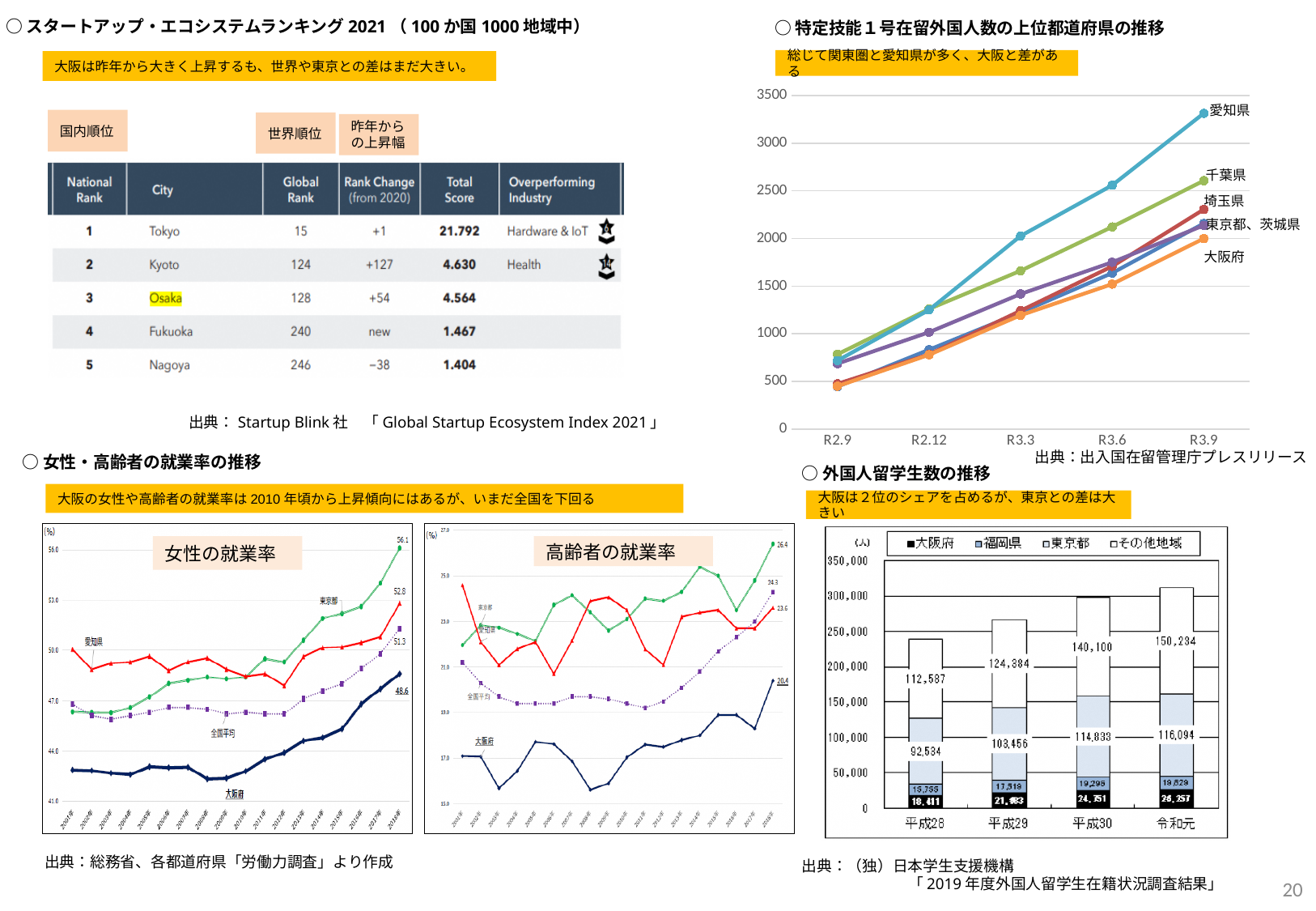
In the 女性の就業率 chart, what is the final labelled value for 愛知県? 52.8 In the bottom-right chart 外国人留学生数の推移, how many series does the legend list? 4 In the top-right chart 特定技能１号在留外国人数の上位都道府県の推移, what kind of chart is it? line chart In the 高齢者の就業率 chart, what is the final labelled value for 大阪府? 20.4 In the top-right chart 特定技能１号在留外国人数の上位都道府県の推移, is the value for 愛知県 at R3.9 greater or less than 3000? greater In the bottom-right chart 外国人留学生数の推移, what is the value for 東京都 in 令和元? 116,094 In the top-right chart 特定技能１号在留外国人数の上位都道府県の推移, how many time points are shown on the x axis? 5 In the top-right chart 特定技能１号在留外国人数の上位都道府県の推移, do the values for 愛知県 rise or fall from R2.9 to R3.9? rise In the top-right chart 特定技能１号在留外国人数の上位都道府県の推移, which prefecture has the highest value at R3.9? 愛知県 In the 女性の就業率 chart, what is the final labelled value for 大阪府? 48.6